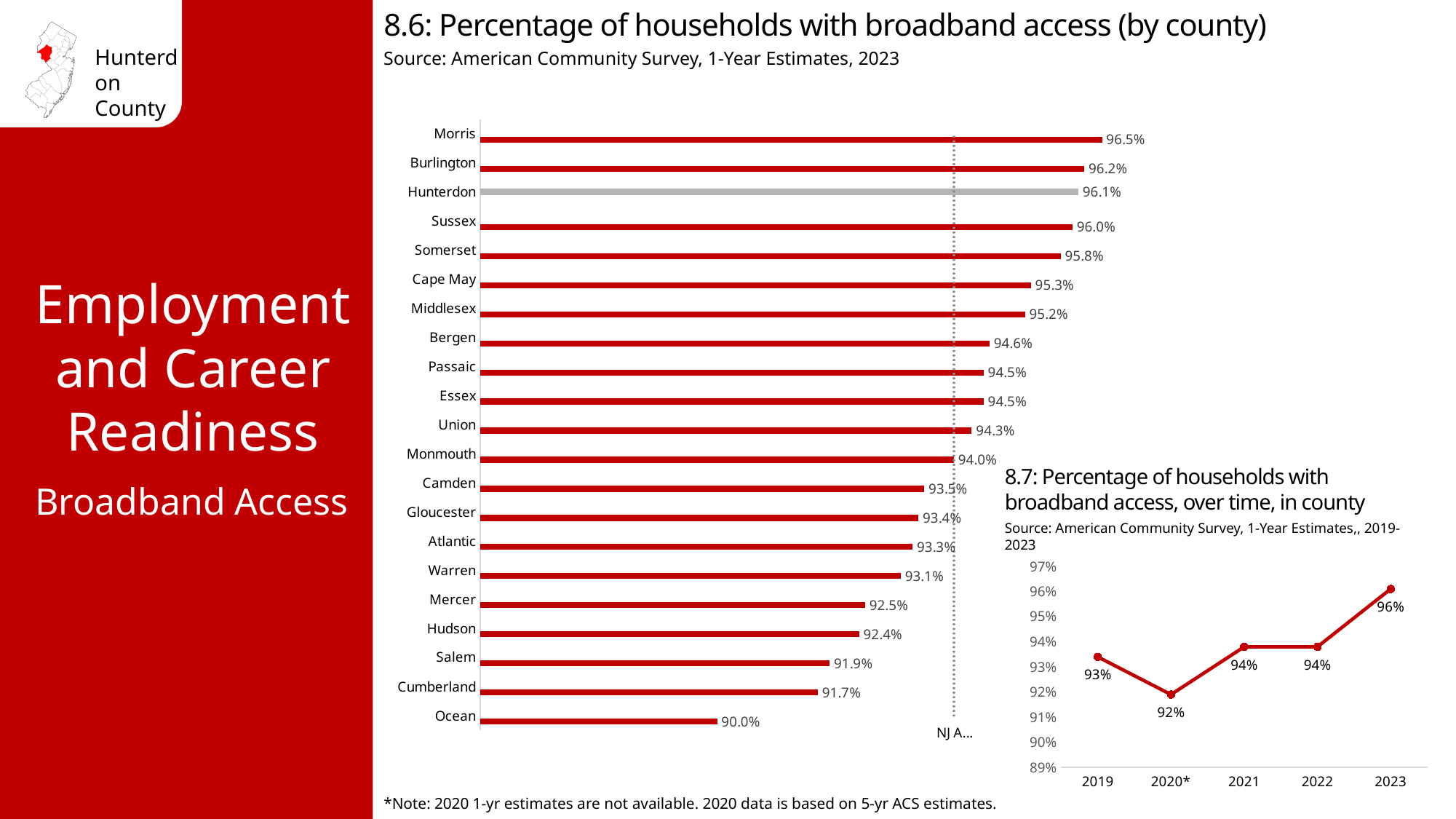
In chart 8.7 (broadband access over time), how many data points are plotted? 5 In chart 8.6 (broadband access by county), which bar is coloured grey instead of red? Hunterdon In chart 8.6 (broadband access by county), which has a higher value, Bergen or Mercer? Bergen In chart 8.6 (broadband access by county), which county has the highest percentage? Morris In chart 8.6 (broadband access by county), what is the value for Cumberland? 91.7% In chart 8.6 (broadband access by county), which county has the lowest percentage? Ocean In chart 8.6 (broadband access by county), what is the value for Hunterdon? 96.1% In chart 8.6 (broadband access by county), what is the difference between Morris and Ocean? 6.5 percentage points In chart 8.7 (broadband access over time), which year has the highest value? 2023 What kind of chart is chart 8.6 (broadband access by county)? Bar chart In chart 8.6 (broadband access by county), how many counties are shown? 21 In chart 8.7 (broadband access over time), what is the value for 2020*? 92%